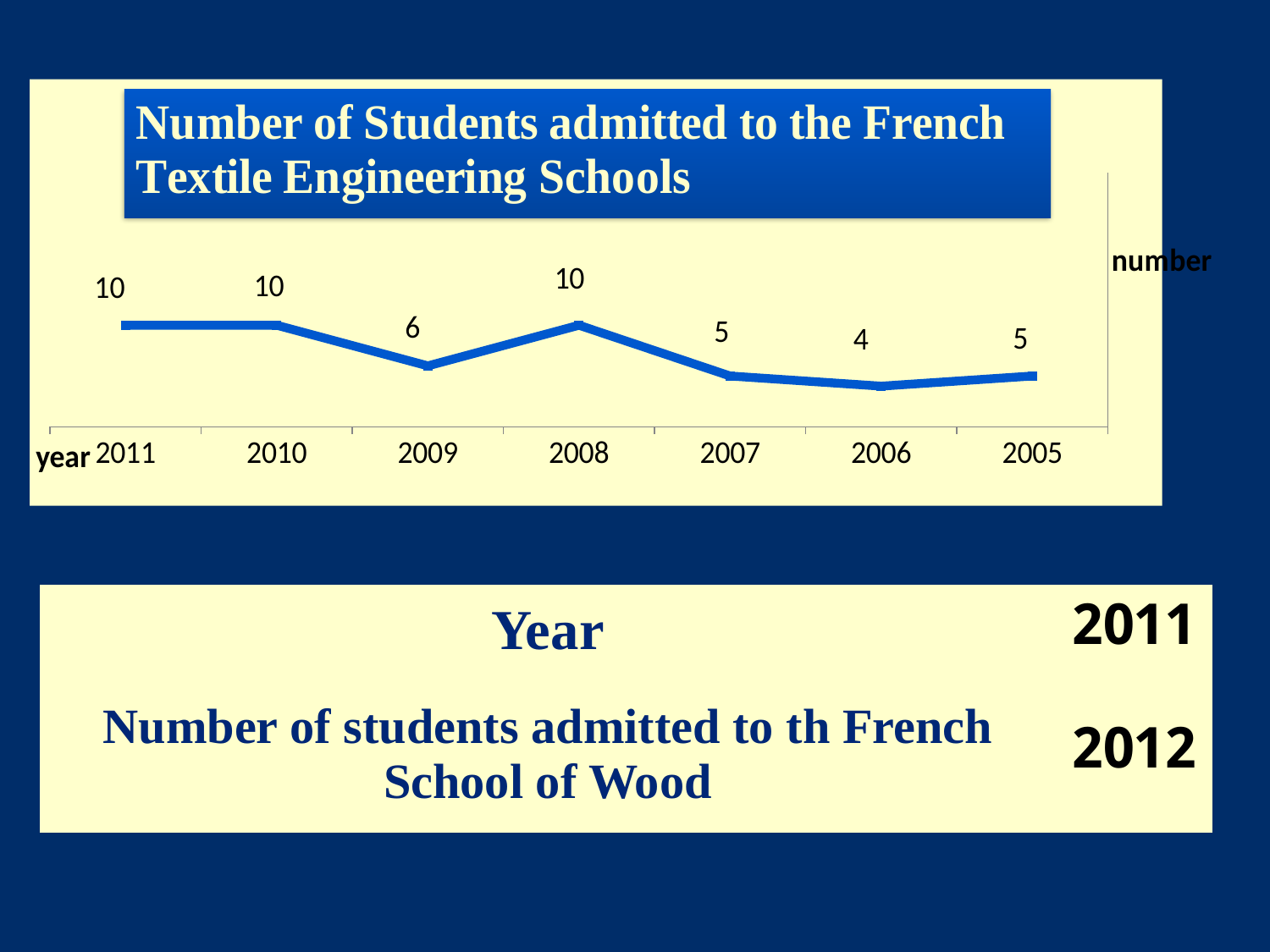
Which year has the lowest number of students admitted? 2006 What is the title of the chart? Number of Students admitted to the French Textile Engineering Schools Which is larger, the number of students admitted in 2009 or in 2007? 2009 What is the difference between the number of students admitted in 2008 and in 2007? 5 What is the number of students admitted in 2008? 10 What type of chart is shown on the slide? line chart How many years are plotted on the chart? 7 Do the values generally rise or fall moving from left to right along the x axis? fall What is the number of students admitted in 2009? 6 What is the difference between the number of students admitted in 2011 and in 2006? 6 What is the number of students admitted in 2005? 5 What is the number of students admitted in 2006? 4